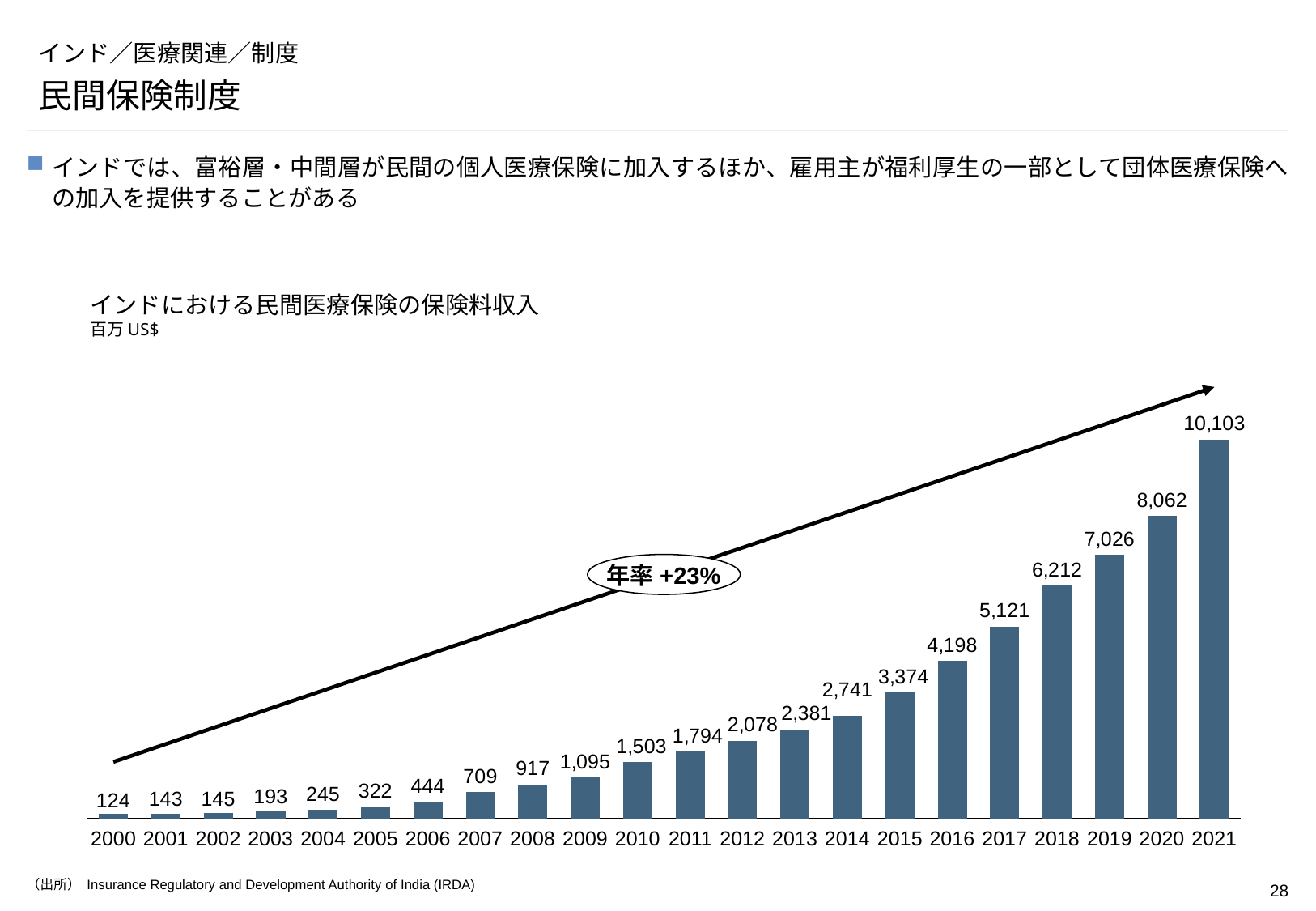
What is the value for 2000? 124 What annual growth rate is shown in the label on the arrow? 年率 +23% Which year has the lowest value? 2000 What kind of chart is this? Bar chart What is the value for 2021? 10,103 What is the value for 2010? 1,503 What is the difference between the values for 2021 and 2020? 2,041 What is the difference between the values for 2015 and 2014? 633 How many years are shown on the x axis? 22 Which is larger, the value for 2008 or the value for 2009? 2009 Do the values rise or fall from 2000 to 2021? Rise Which year has the highest value? 2021